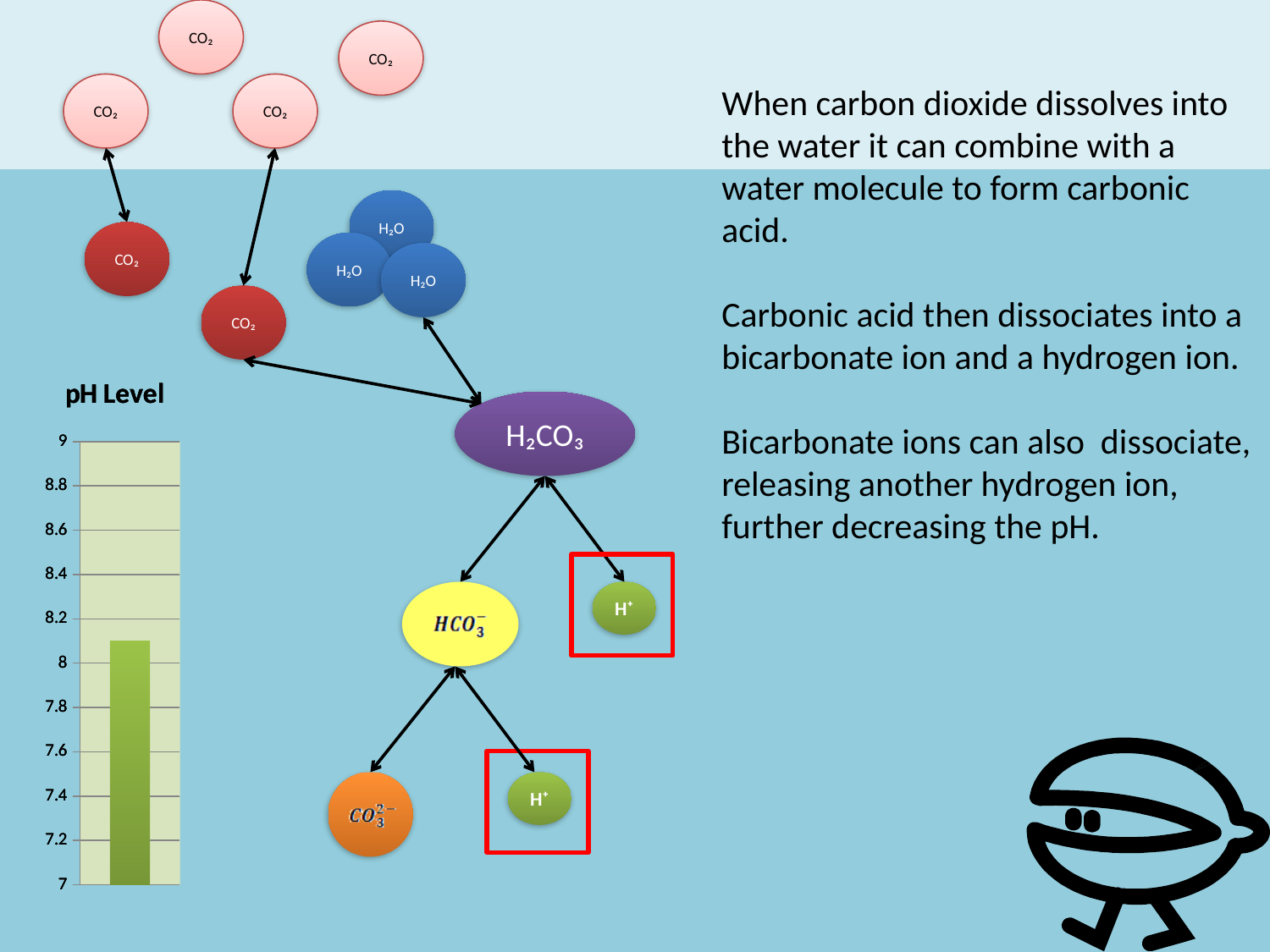
In the pH Level chart, is the value of the bar greater or less than 8? greater What is the title of the chart on the slide? pH Level What kind of chart is shown on the slide? bar chart In the pH Level chart, is the value of the bar greater or less than 9? less How many bars are plotted in the pH Level chart? 1 What is the lowest value shown on the vertical axis of the pH Level chart? 7 In the pH Level chart, is the value of the bar greater or less than 7.6? greater